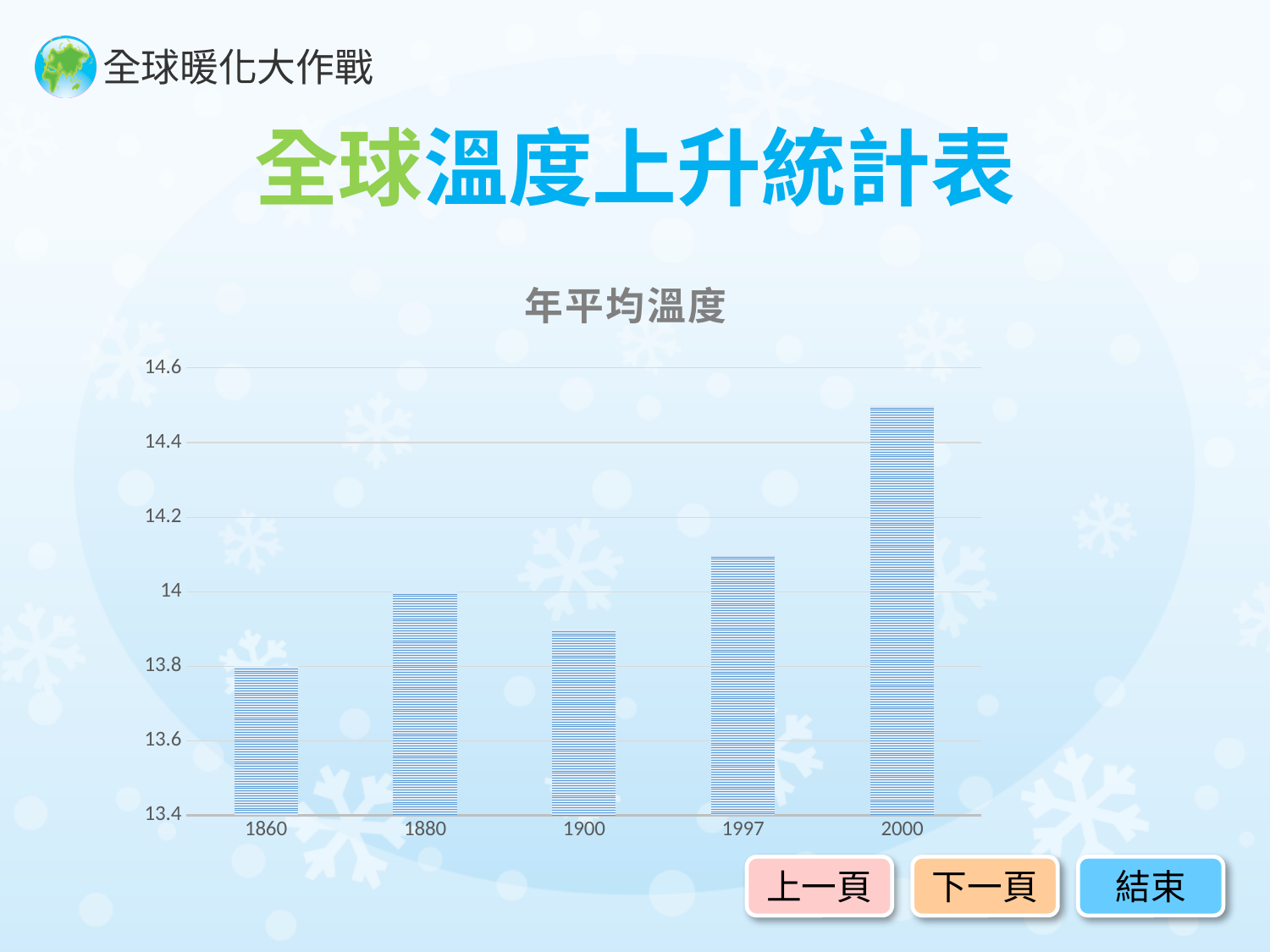
What is the title of the chart? 年平均溫度 Is the value for 1900 greater or less than 14? less Is the value for 1860 greater or less than 14? less Which year has the lowest bar in the chart? 1860 Is the value for 1880 greater or less than 13.8? greater Which has the larger value, 1997 or 1900? 1997 How many years (categories) are shown on the x axis of the chart? 5 What type of chart is shown on the slide? bar chart Which year has the highest bar in the chart? 2000 Which has the larger value, 1880 or 1860? 1880